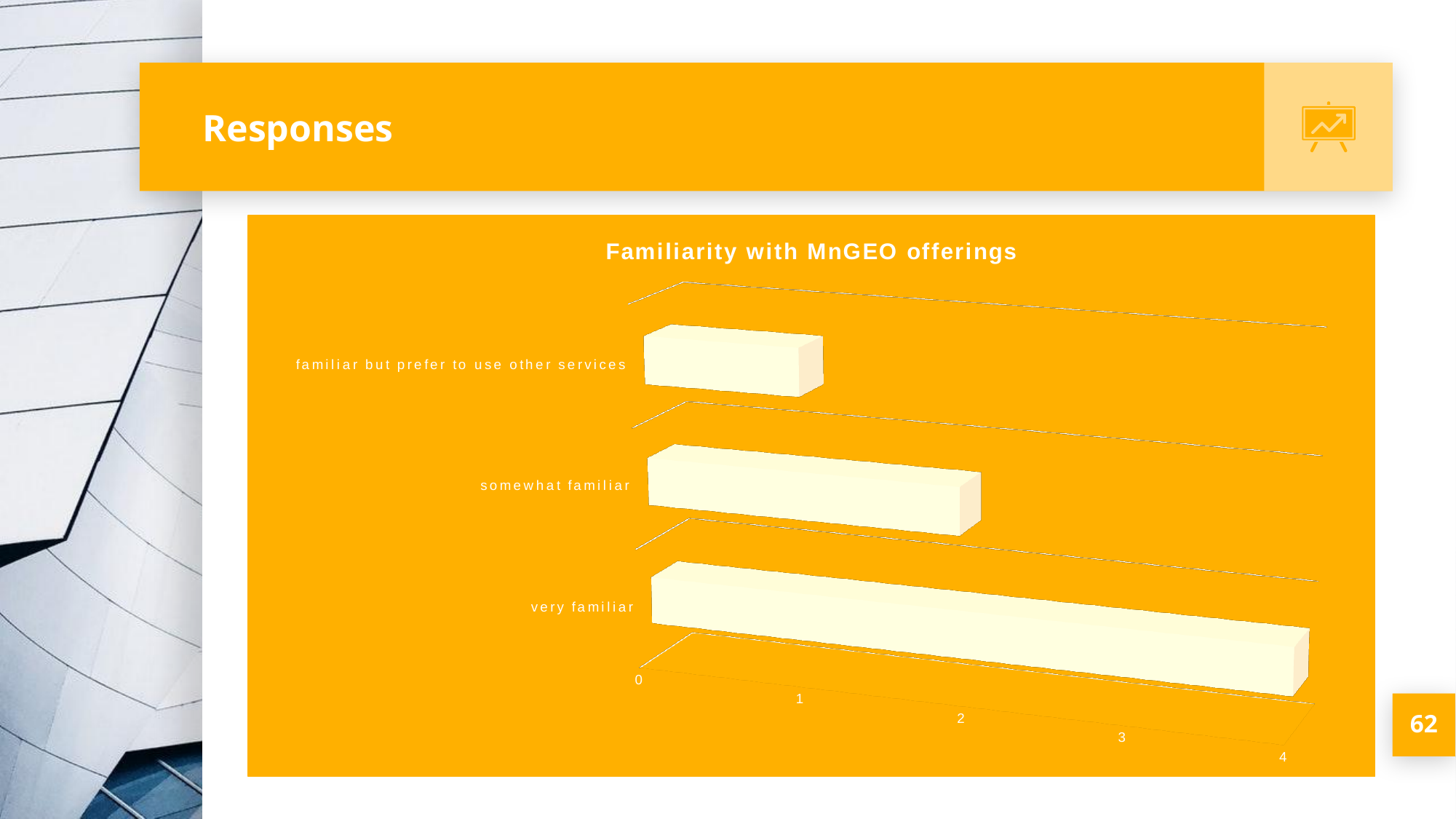
What is the title of the chart? Familiarity with MnGEO offerings Which category has the lowest value? familiar but prefer to use other services Is the value for 'somewhat familiar' greater or less than 3? less Is the value for 'very familiar' greater or less than 3? greater How many categories are shown in the chart? 3 Is the value for 'somewhat familiar' greater or less than 1? greater What is the highest tick value shown on the value axis? 4 Which category has the highest value? very familiar Which is larger: the value for 'very familiar' or the value for 'somewhat familiar'? very familiar Which is larger: the value for 'somewhat familiar' or the value for 'familiar but prefer to use other services'? somewhat familiar What kind of chart is shown on the slide? bar chart